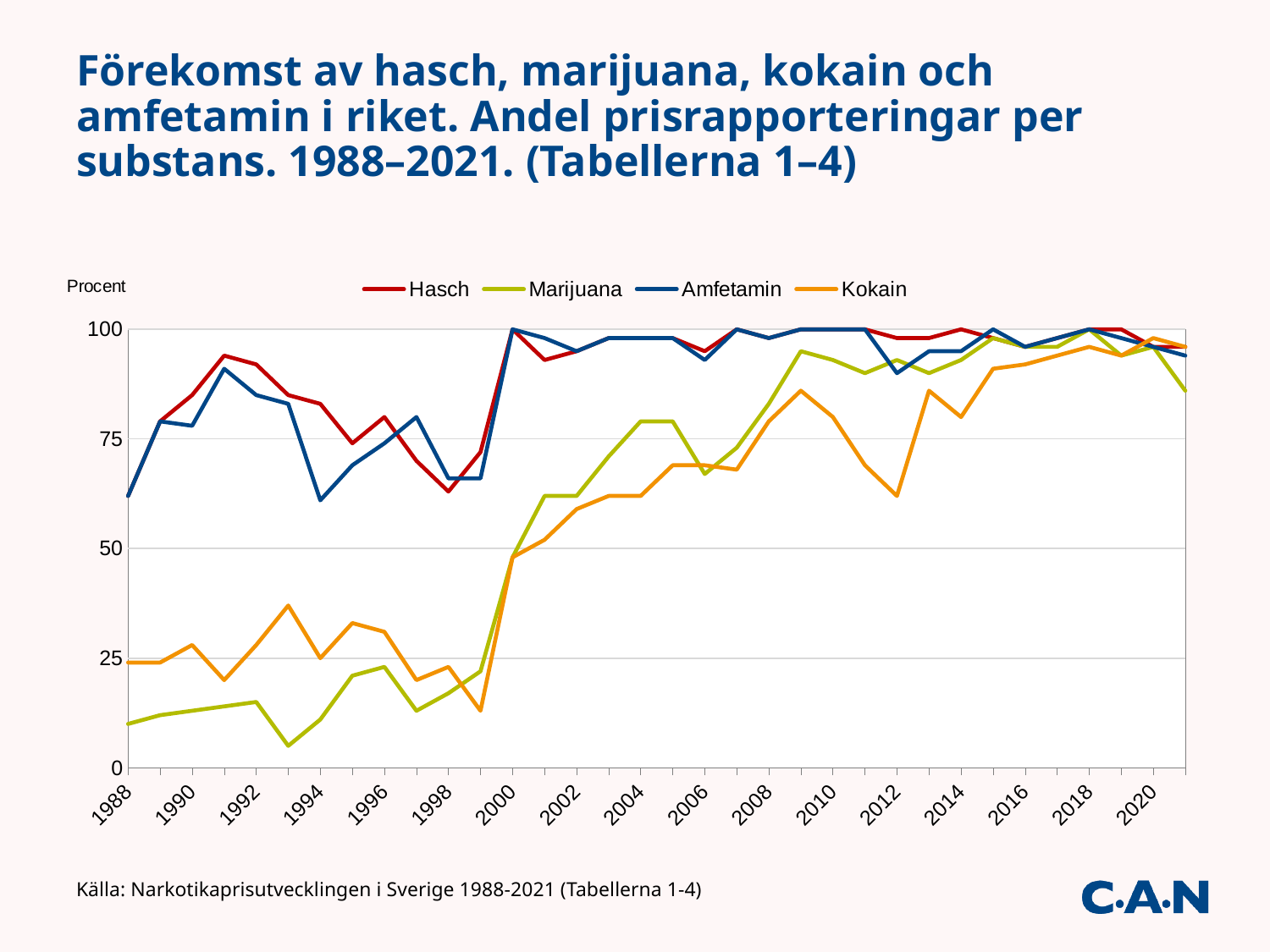
Does the Marijuana line generally rise or fall from 1988 to 2021? rise Is the value for Marijuana in 1988 greater or less than 25? less Is the value for Kokain in 2012 greater or less than 75? less How many series does the legend list? 4 Which series has the lowest value in 1988? Marijuana Is the value for Amfetamin in 1994 greater or less than 50? greater What is the label on the vertical axis? Procent Which series are listed in the legend? Hasch, Marijuana, Amfetamin, Kokain What kind of chart is shown on the slide? line chart In 2004, which is higher, Marijuana or Kokain? Marijuana